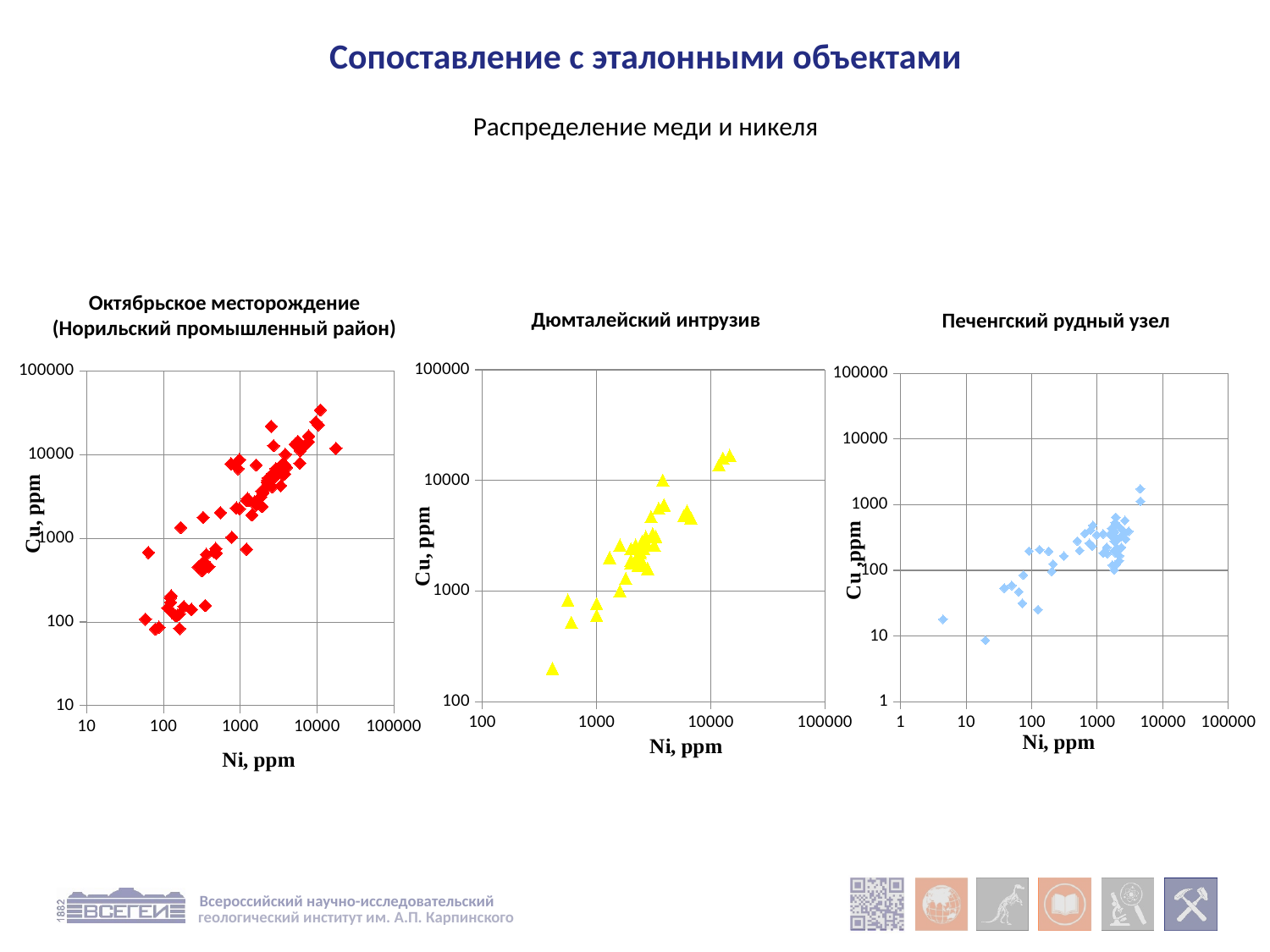
How many charts are shown on the slide? 3 In the 'Печенгский рудный узел' chart, is the highest Cu value greater or less than 10000? less What kind of chart is the 'Дюмталейский интрузив' chart? scatter chart In the 'Дюмталейский интрузив' chart, is the lowest Cu value greater or less than 1000? less What colour are the markers in the 'Дюмталейский интрузив' chart? yellow What is the x-axis title of the 'Дюмталейский интрузив' chart? Ni, ppm In the 'Дюмталейский интрузив' chart, is the highest Cu value greater or less than 10000? greater In the 'Печенгский рудный узел' chart, do Cu values generally rise or fall as Ni increases? rise In the 'Октябрьское месторождение (Норильский промышленный район)' chart, do Cu values generally rise or fall as Ni increases? rise